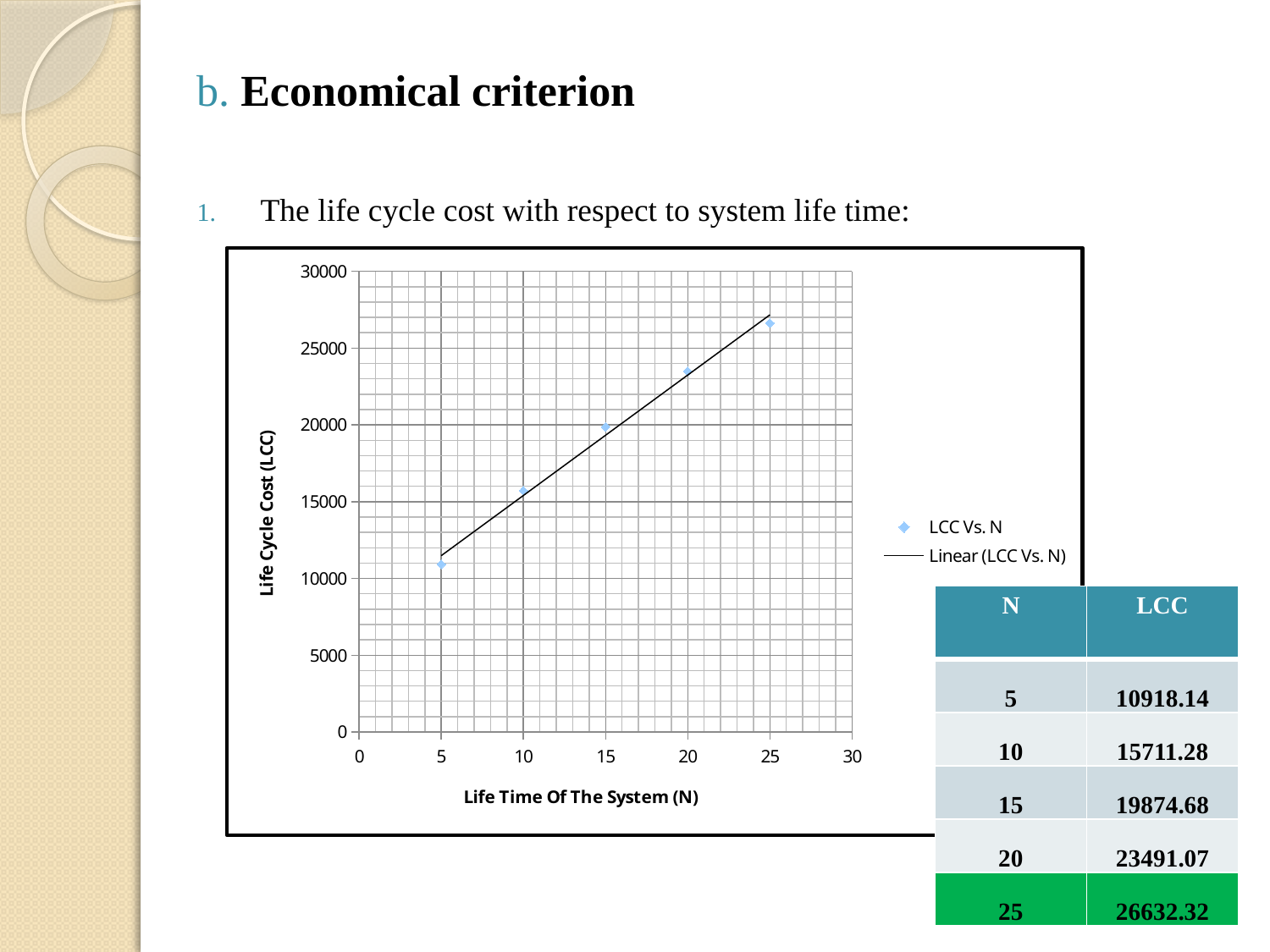
How many data points are plotted in the LCC Vs. N chart? 5 What kind of chart is shown on the slide? scatter chart How many entries does the chart legend list? 2 Which value of N has the highest LCC? 25 Is the plotted LCC value for N = 20 greater or less than 25000? less What is the label of the x axis of the chart? Life Time Of The System (N) According to the table, what is the LCC for N = 5? 10918.14 According to the table, what is the LCC for N = 25? 26632.32 Does the life cycle cost rise or fall as the life time of the system increases? rises According to the table, what is the LCC for N = 15? 19874.68 Using the table values, what is the difference between the LCC at N = 25 and the LCC at N = 5? 15714.18 What is the label of the y axis of the chart? Life Cycle Cost (LCC)